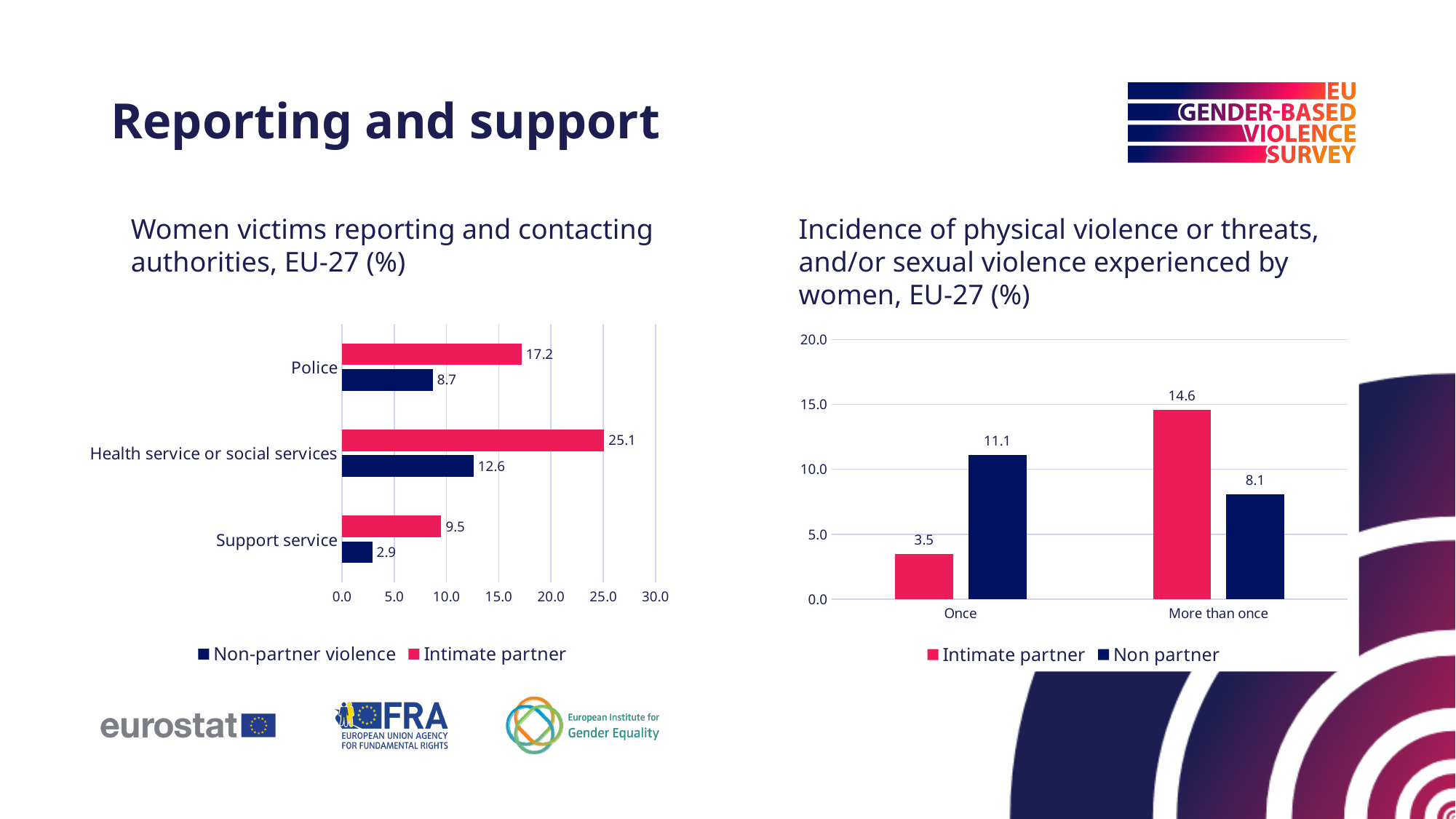
In the left chart (Women victims reporting and contacting authorities), what is the Non-partner violence value for Health service or social services? 12.6 What kind of chart is the left chart (Women victims reporting and contacting authorities)? Bar chart In the left chart (Women victims reporting and contacting authorities), what is the Intimate partner value for Police? 17.2 In the left chart (Women victims reporting and contacting authorities), which category has the lowest Non-partner violence value? Support service In the right chart (Incidence of physical violence or threats), what is the difference between the Intimate partner and Non partner values for More than once? 6.5 In the left chart (Women victims reporting and contacting authorities), how many categories are shown? 3 In the left chart (Women victims reporting and contacting authorities), which category has the highest Intimate partner value? Health service or social services How many series does the legend of the right chart (Incidence of physical violence or threats) list? 2 In the right chart (Incidence of physical violence or threats), what is the Non partner value for Once? 11.1 In the left chart (Women victims reporting and contacting authorities), what is the difference between the Intimate partner and Non-partner violence values for Support service? 6.6 In the right chart (Incidence of physical violence or threats), what is the Intimate partner value for More than once? 14.6 In the right chart (Incidence of physical violence or threats), which is larger for Once: Intimate partner or Non partner? Non partner